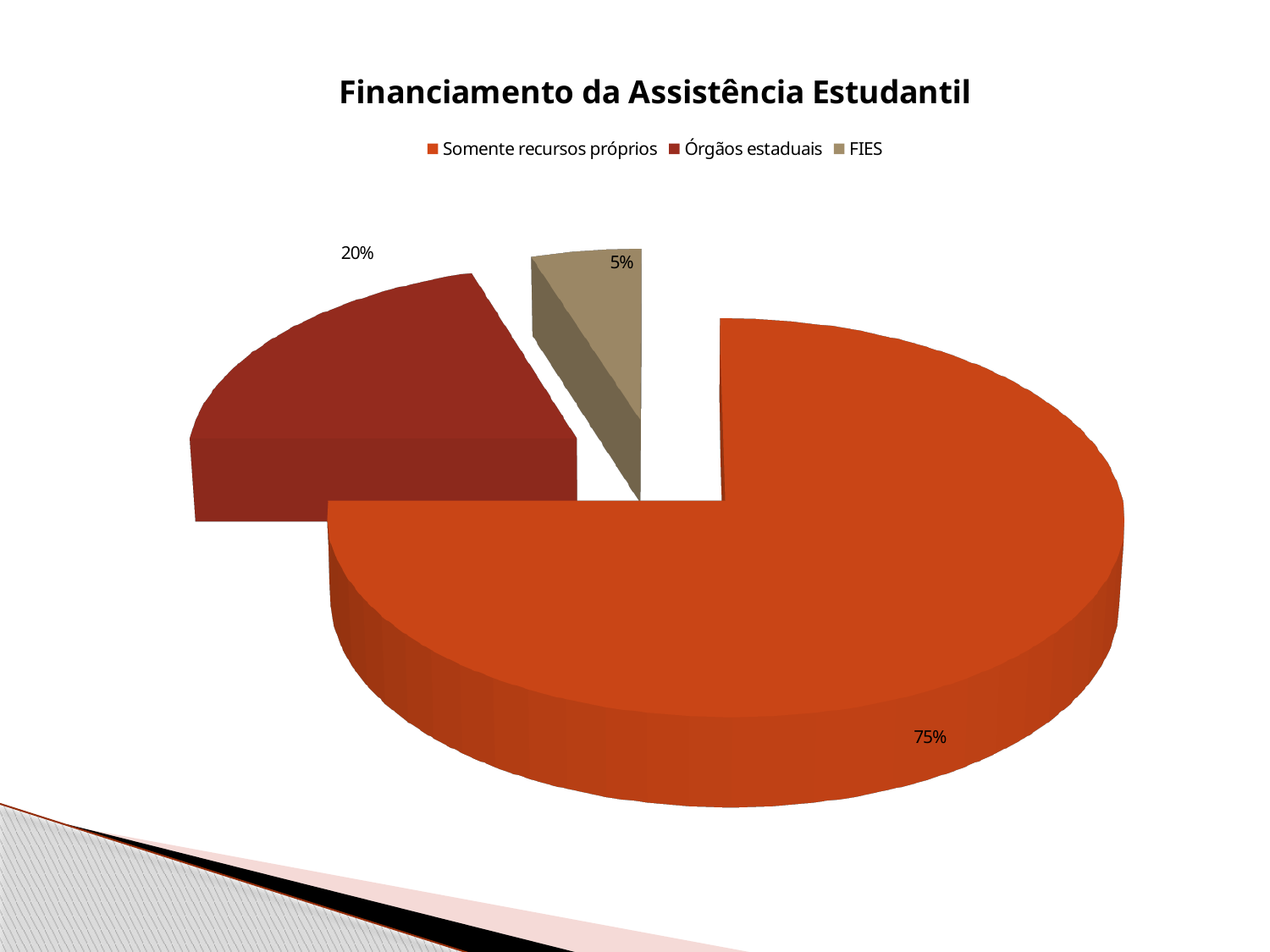
What share of the pie does 'Somente recursos próprios' represent? 75% What is the title of the chart? Financiamento da Assistência Estudantil Which is larger, the slice for 'Órgãos estaduais' or the slice for 'FIES'? Órgãos estaduais What kind of chart is shown on the slide? Pie chart What share of the pie does 'FIES' represent? 5% How many entries does the legend list? 3 What is the difference in percentage points between 'Somente recursos próprios' and 'Órgãos estaduais'? 55 percentage points How many categories are shown in the pie chart? 3 Which category has the largest slice of the pie? Somente recursos próprios What share of the pie does 'Órgãos estaduais' represent? 20% What is the combined share of 'Órgãos estaduais' and 'FIES'? 25% Which category has the smallest slice of the pie? FIES